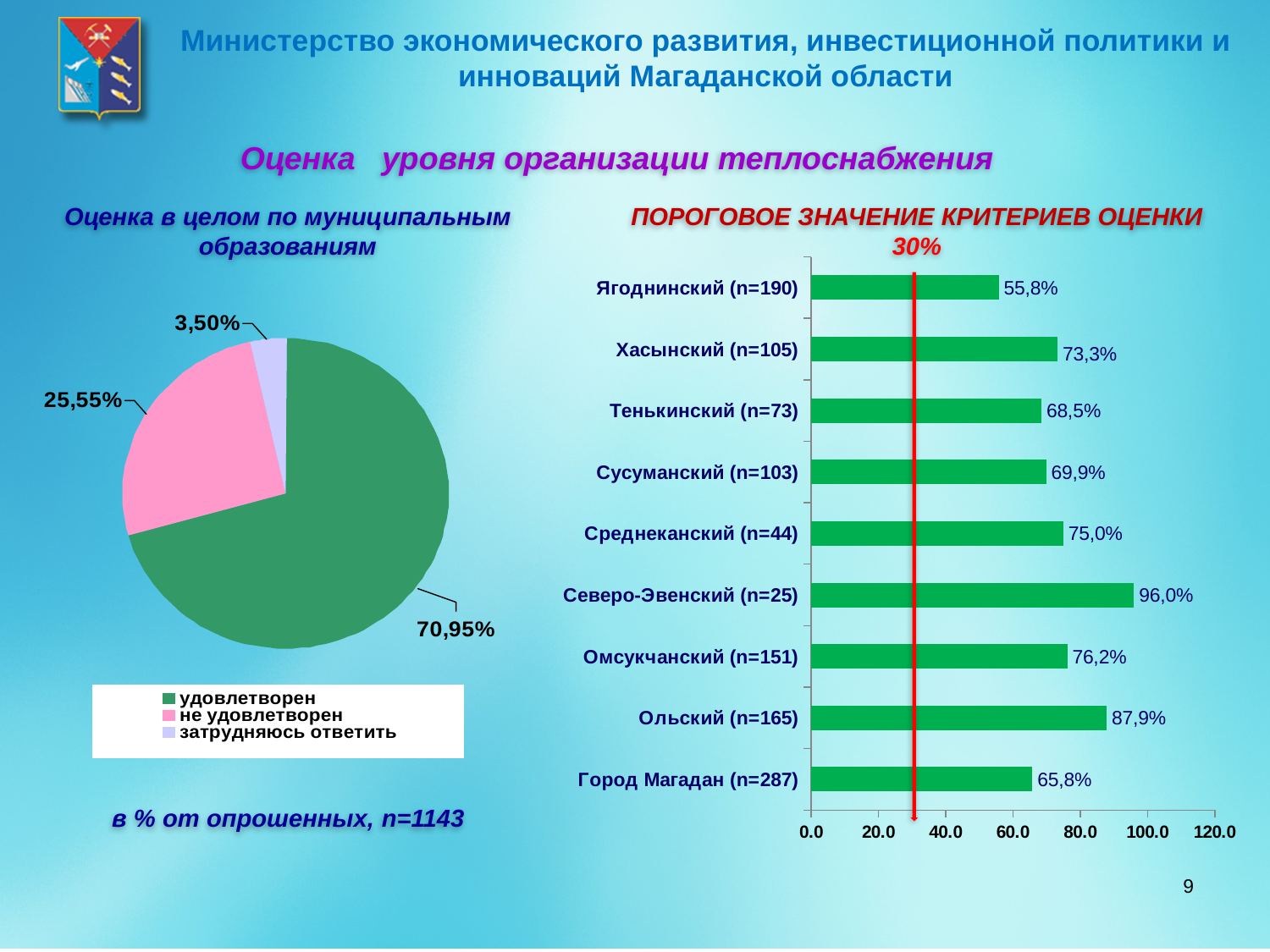
In the pie chart on the left, what share of respondents answered "удовлетворен"? 70,95% In the pie chart on the left, which category has the smallest slice? затрудняюсь ответить In the bar chart on the right, which municipality has the lowest value? Ягоднинский (n=190) In the bar chart on the right, which is larger: the value for Хасынский (n=105) or Тенькинский (n=73)? Хасынский (n=105) In the bar chart on the right, what is the difference between the values for Ольский (n=165) and Ягоднинский (n=190)? 32,1% What type of chart is shown on the right side of the slide? bar chart In the bar chart on the right, what is the value for Северо-Эвенский (n=25)? 96,0% In the pie chart on the left, what share of respondents answered "затрудняюсь ответить"? 3,50% In the pie chart on the left, how many categories does the legend list? 3 In the bar chart on the right, which municipality has the highest value? Северо-Эвенский (n=25) In the bar chart on the right, what is the value for Город Магадан (n=287)? 65,8% In the bar chart on the right, how many municipalities are shown? 9